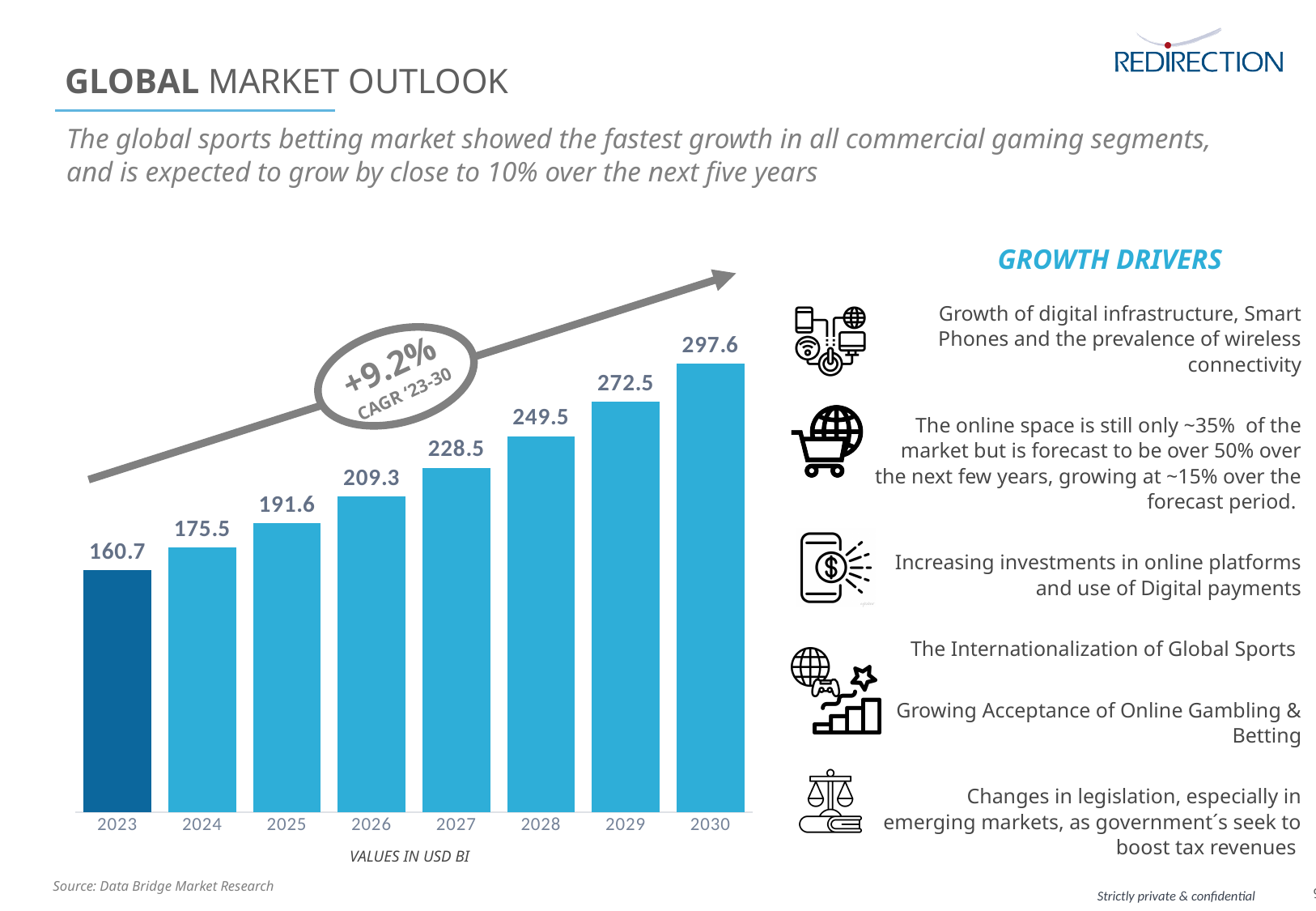
What CAGR for 2023-2030 is annotated on the chart? +9.2% What is the value for 2027? 228.5 How many years are shown on the x axis? 8 What kind of chart is shown? Bar chart What is the value for 2023? 160.7 Which year has the lowest value? 2023 Which year has the highest value? 2030 What is the value for 2030? 297.6 What is the difference between the values for 2026 and 2025? 17.7 What is the difference between the values for 2030 and 2023? 136.9 Do the values rise or fall from 2023 to 2030? Rise Which is larger, the value for 2028 or the value for 2029? 2029